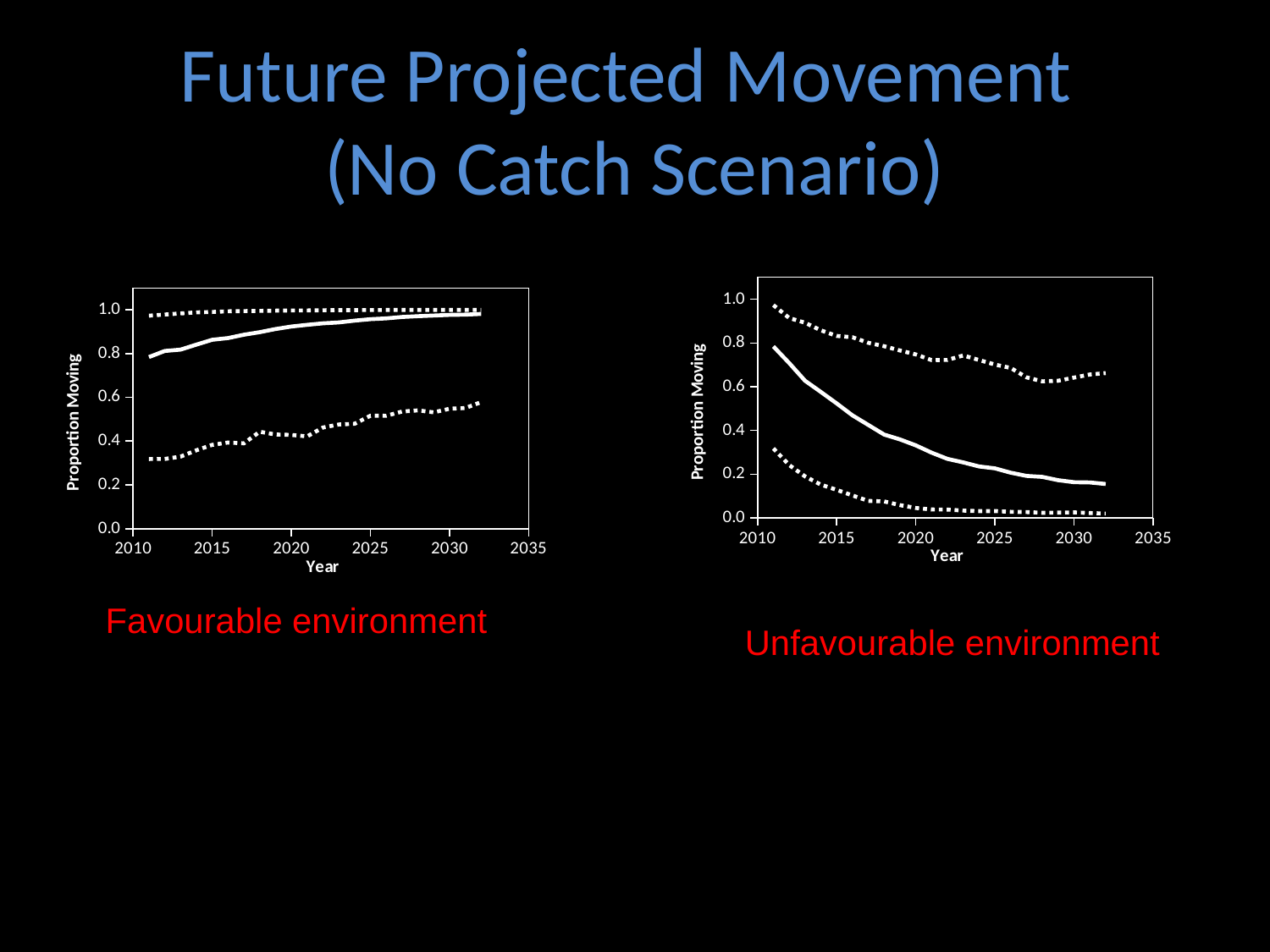
In the 'Unfavourable environment' chart, does the solid line rise or fall from 2011 to 2032? fall In the 'Unfavourable environment' chart, does the lower dotted line rise or fall over the years shown? fall What kind of chart is the 'Favourable environment' chart on the left? line chart In the 'Unfavourable environment' chart, is the value of the upper dotted line in 2032 greater or less than 0.6? greater What is the label of the y axis on the 'Favourable environment' chart? Proportion Moving In the 'Favourable environment' chart, is the value of the solid line in 2011 greater or less than 0.6? greater In the 'Favourable environment' chart, is the value of the lower dotted line in 2011 greater or less than 0.4? less In the 'Favourable environment' chart, does the solid line rise or fall from 2011 to 2032? rise What is the label of the x axis on the 'Unfavourable environment' chart? Year What kind of chart is the 'Unfavourable environment' chart on the right? line chart How many lines are plotted in the 'Unfavourable environment' chart? 3